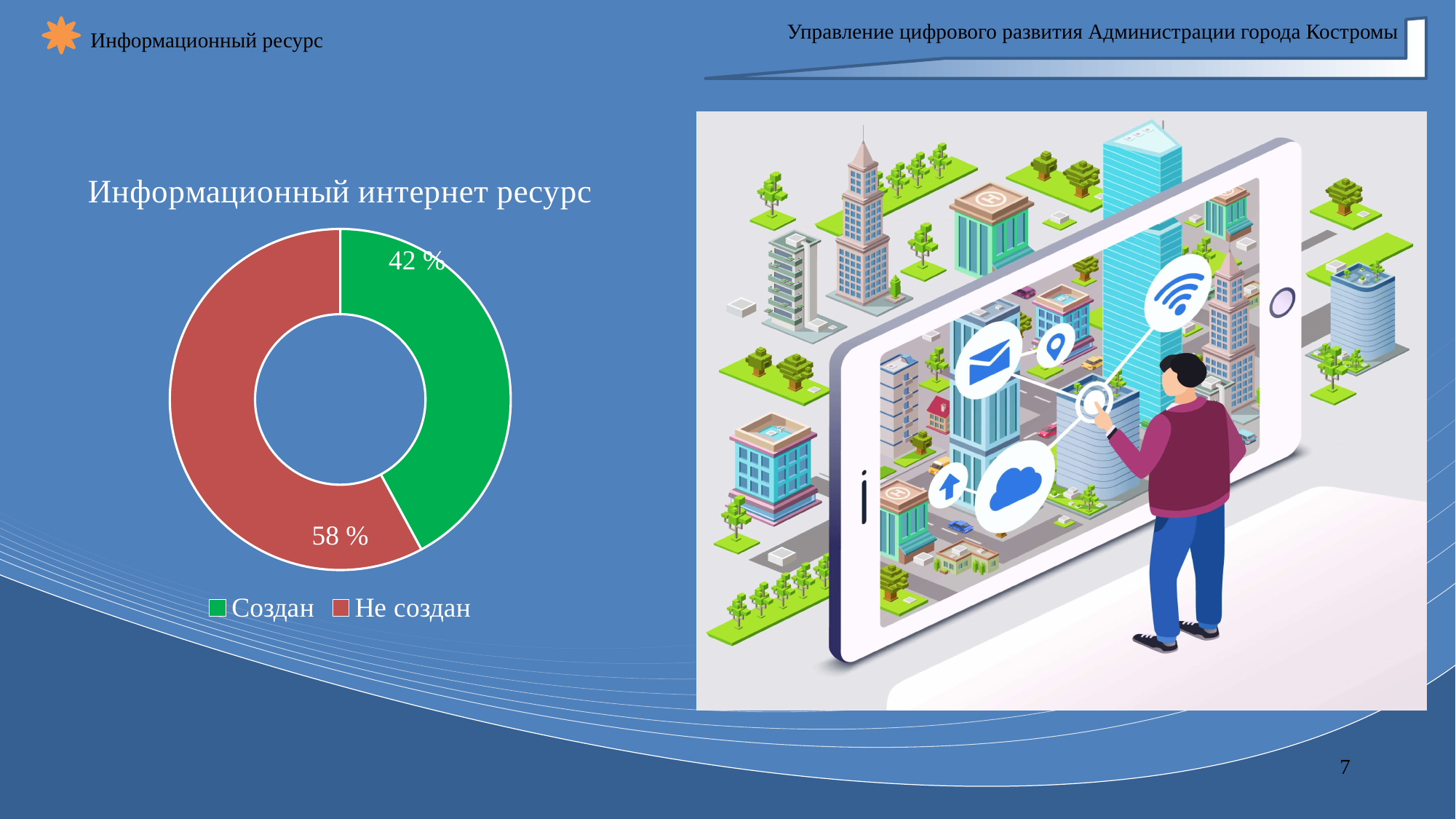
What is the value for "Создан" in the chart? 42 % What is the value for "Не создан" in the chart? 58 % What kind of chart is shown on the slide? Doughnut (pie) chart Which category has the largest share in the chart? Не создан How many categories does the chart show? 2 Which is larger, the share for "Создан" or for "Не создан"? Не создан What colour represents "Создан" in the chart? Green What is the difference between the "Не создан" and "Создан" shares? 16 % How many entries does the legend list? 2 What is the title of the chart? Информационный интернет ресурс What share of the chart does the "Не создан" slice take? 58 % Which category has the smallest share in the chart? Создан